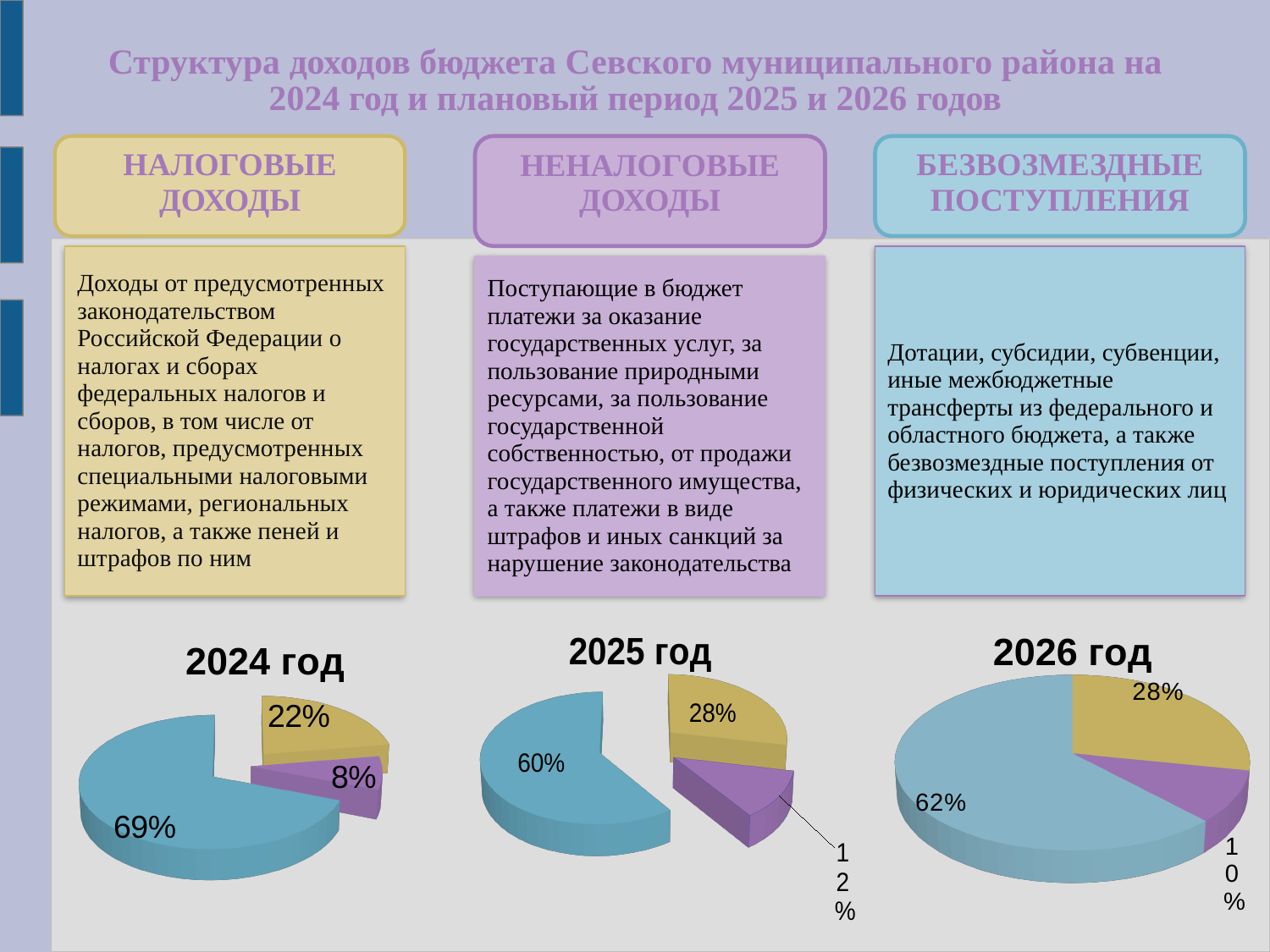
Is the blue slice larger in the 2025 год chart or in the 2026 год chart? 2026 год (62% vs 60%) In the 2024 год chart, what percentage is shown for the largest (blue) slice? 69% In the 2024 год chart, what percentage is shown for the purple slice? 8% In the 2026 год chart, which slice has the smallest share? The purple slice (10%) In the 2025 год chart, which slice has the largest share? The blue slice (60%) What kind of chart is used for the 2024 год chart? Pie chart In the 2024 год chart, what is the difference in percentage points between the yellow slice and the purple slice? 14 percentage points In the 2025 год chart, what percentage is shown for the purple slice? 12% How many pie charts are shown on the slide? 3 How many slices does the 2025 год pie chart have? 3 In the 2026 год chart, what percentage is shown for the yellow slice? 28% In the 2026 год chart, what is the difference in percentage points between the blue slice and the yellow slice? 34 percentage points